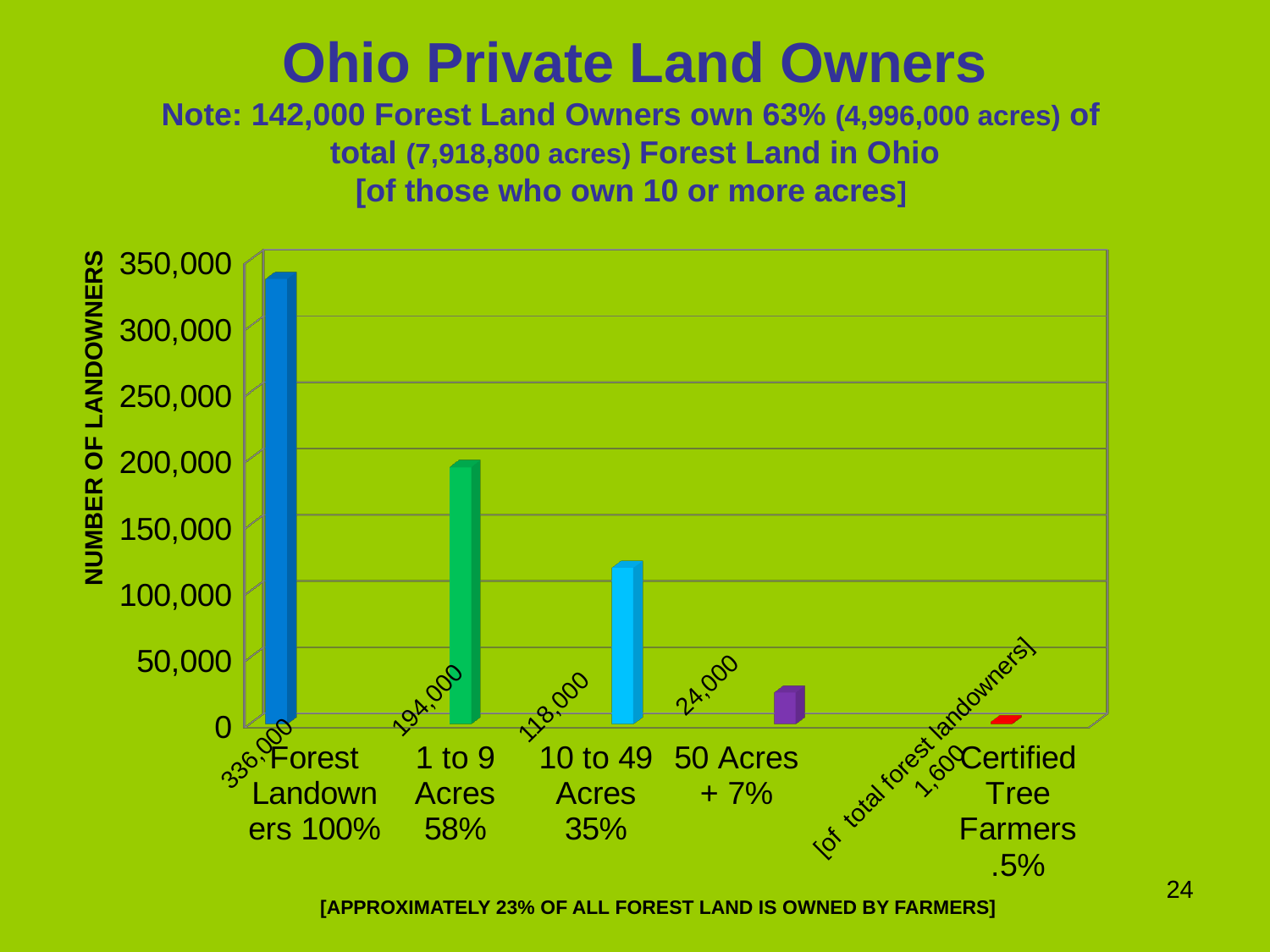
Which category has the lowest number of landowners? Certified Tree Farmers .5% What is the value for 10 to 49 Acres 35%? 118,000 What is the difference between the values for 1 to 9 Acres 58% and 10 to 49 Acres 35%? 76,000 What is the value for 1 to 9 Acres 58%? 194,000 What is the value for 50 Acres + 7%? 24,000 Which is larger, the value for 10 to 49 Acres 35% or the value for 50 Acres + 7%? 10 to 49 Acres 35% What is the value for Forest Landowners 100%? 336,000 What is the label of the vertical axis? NUMBER OF LANDOWNERS What kind of chart is shown on the slide? Bar chart Which category has the highest number of landowners? Forest Landowners 100% What is the value for Certified Tree Farmers .5%? 1,600 How many categories are shown on the chart? 5